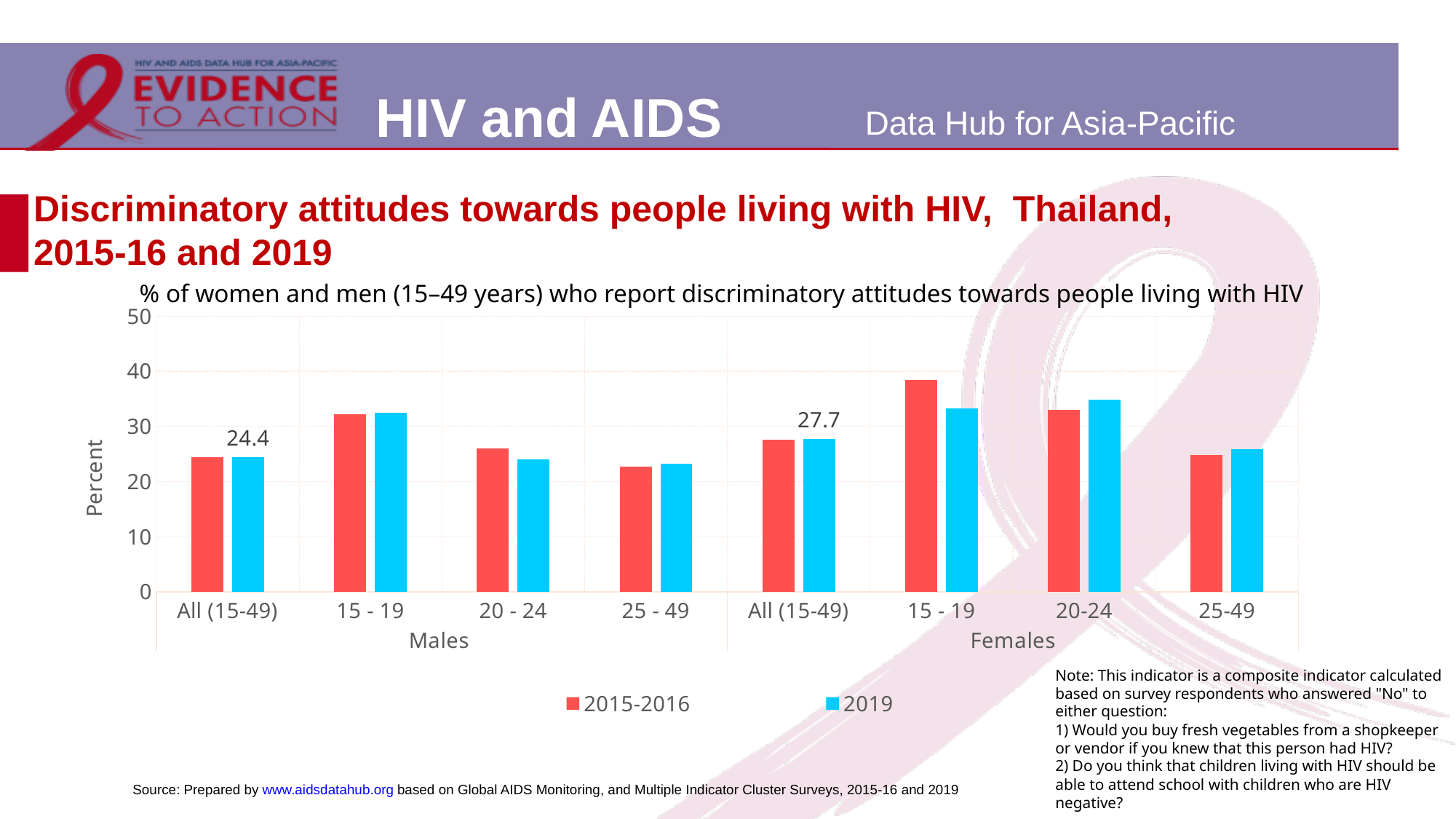
For Females 15 - 19, which is larger: the 2015-2016 value or the 2019 value? 2015-2016 What is the 2019 value for All (15-49) Females? 27.7 Which category has the highest bar on the chart? Females 15 - 19 (2015-2016) Is the 2015-2016 value for Females 15 - 19 greater or less than 30? greater Among the 2015-2016 bars, which category is the lowest? Males 25 - 49 What is the difference between the 2019 values for All (15-49) Females and All (15-49) Males? 3.3 What is the 2019 value for All (15-49) Males? 24.4 How many age-group categories are shown on the x axis? 8 How many series does the legend list? 2 What kind of chart is shown on the slide? bar chart In 2019, which is larger: the value for All (15-49) Females or All (15-49) Males? All (15-49) Females Is the 2015-2016 value for Males 25 - 49 greater or less than 30? less